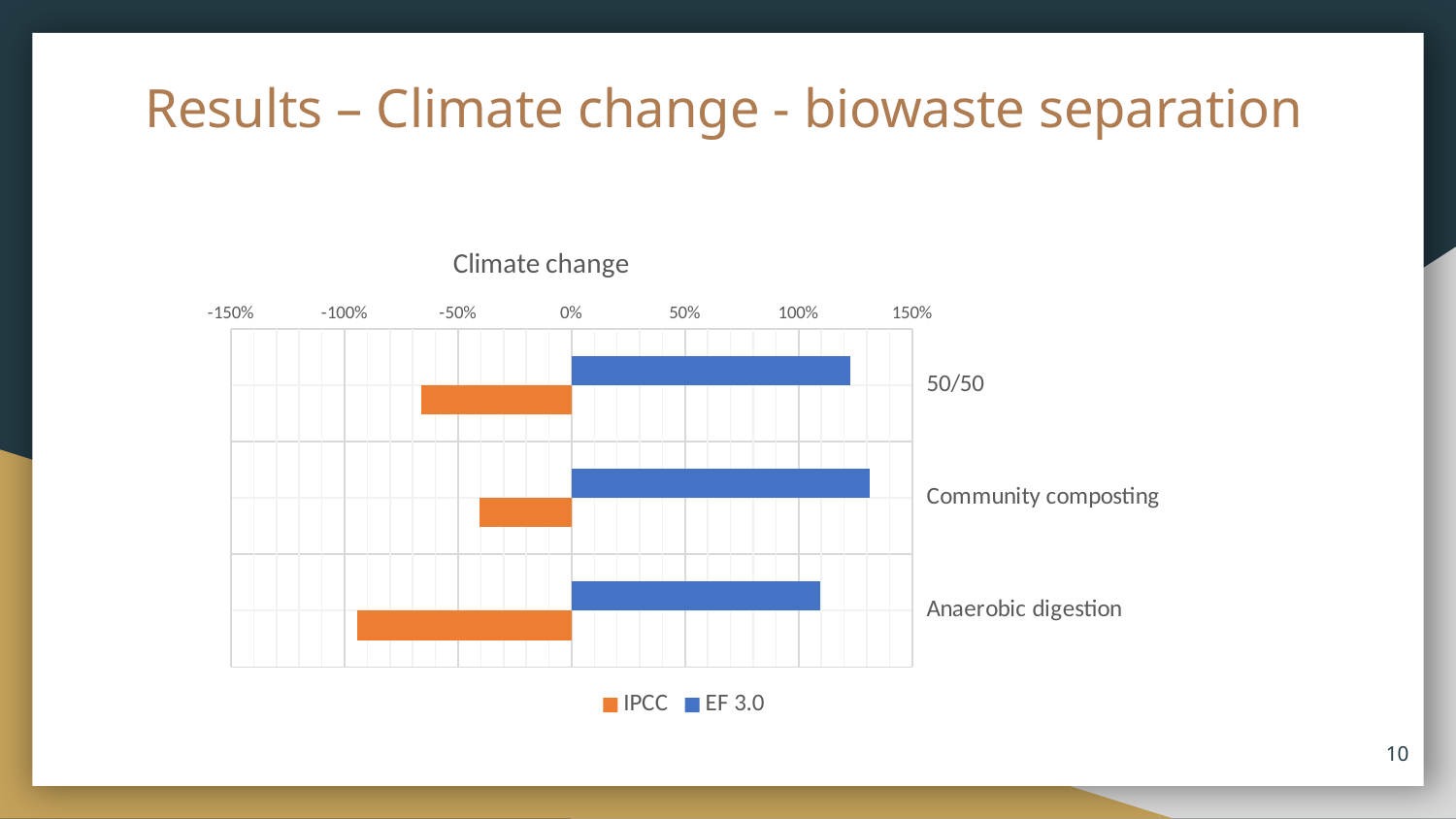
What is the title of the chart? Climate change How many categories are plotted on the chart? 3 Is the EF 3.0 value for 50/50 greater or less than 100%? greater Which is larger, the IPCC value for Community composting or the IPCC value for 50/50? Community composting Which is larger, the EF 3.0 value for 50/50 or the EF 3.0 value for Anaerobic digestion? 50/50 Is the IPCC value for Community composting greater or less than -50%? greater Is the IPCC value for Anaerobic digestion greater or less than -50%? less Which category has the lowest IPCC value? Anaerobic digestion What type of chart is shown on the slide? Bar chart Which colour represents the IPCC series? Orange How many series does the legend list? 2 Which category has the highest EF 3.0 value? Community composting